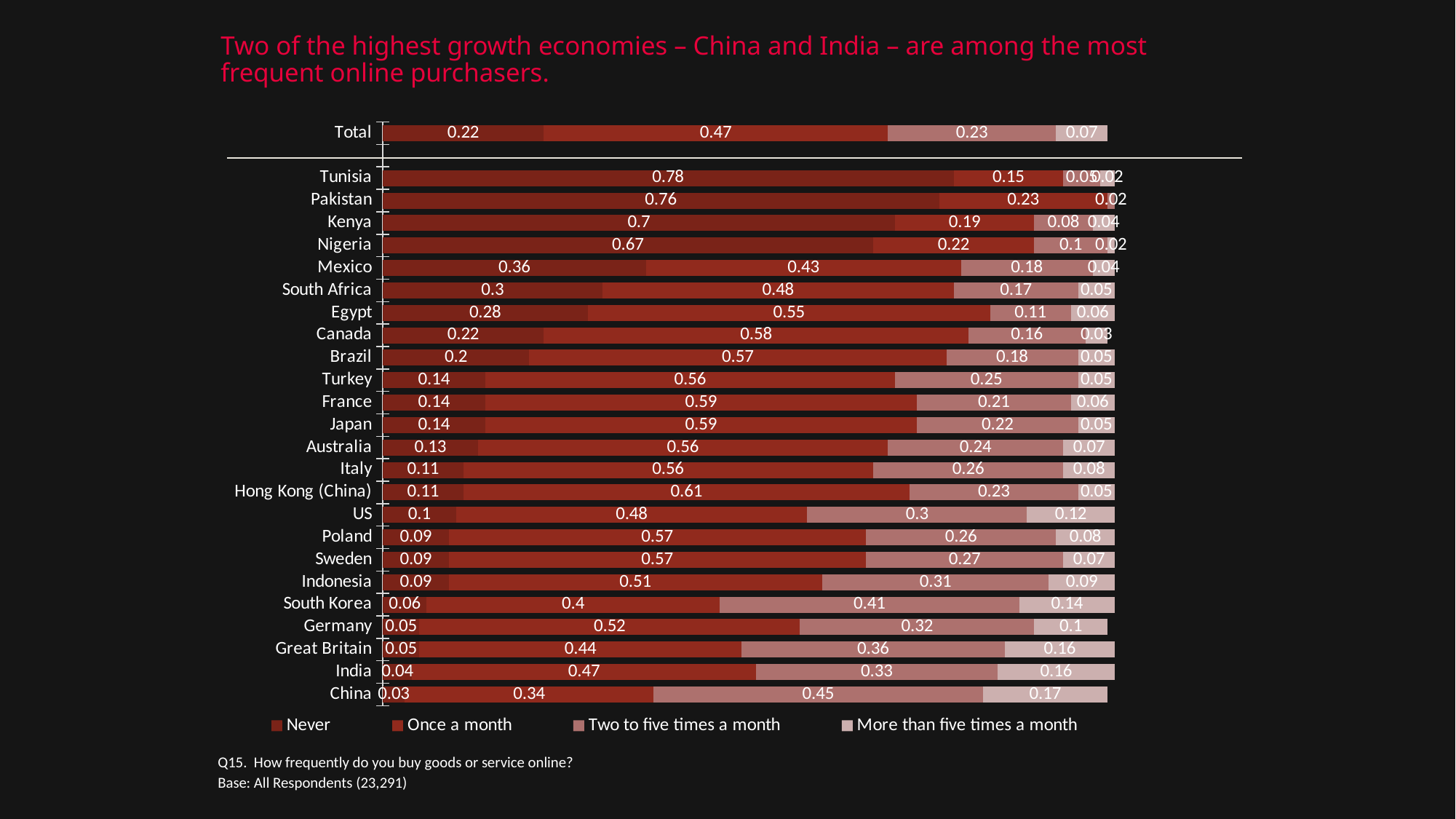
What is the Once a month value for the Total bar? 0.47 Which country has the lowest value in the Never series? China What is the value for the US in the Two to five times a month series? 0.3 What kind of chart is shown on the slide? Stacked bar chart How many countries (excluding Total) are shown in the chart? 24 What is the difference between the Never values for Tunisia and Pakistan? 0.02 Which country has the highest value in the Never series? Tunisia How many series does the legend list? 4 What is the value for Tunisia in the Never series? 0.78 What is the difference between the Once a month values for Canada and Total? 0.11 What is the value for China in the More than five times a month series? 0.17 Which has the larger Two to five times a month value, South Korea or Germany? South Korea